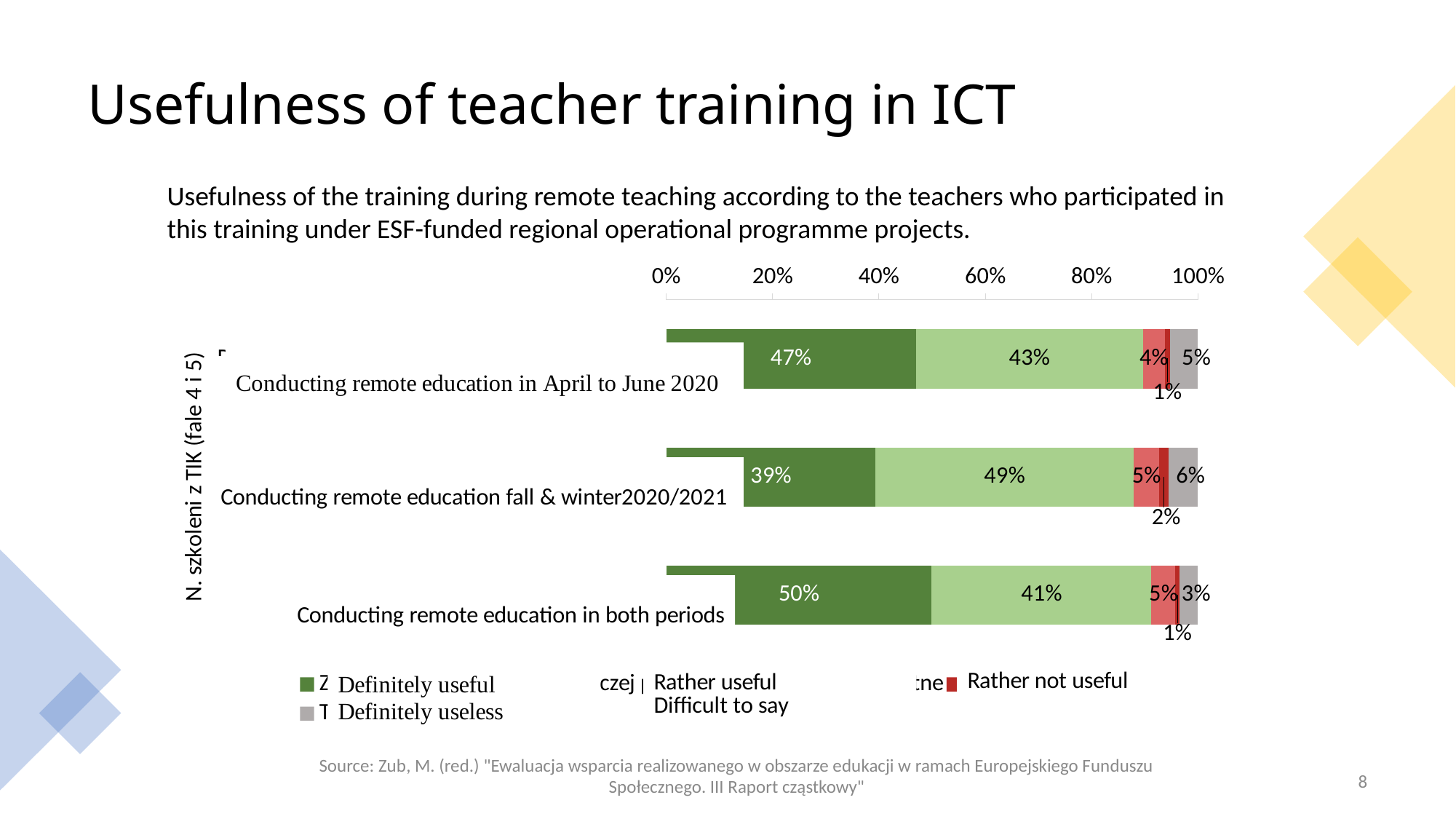
What percentage of teachers who conducted remote education in April to June 2020 found the training definitely useful? 47% How many series does the legend list? 5 Is the 'Rather useful' share larger for teachers in April to June 2020 or for teachers in fall & winter 2020/2021? Fall & winter 2020/2021 What kind of chart is shown on the slide? Stacked bar chart What is the combined share of 'Definitely useful' and 'Rather useful' for teachers conducting remote education in April to June 2020? 90% What percentage of teachers who conducted remote education in both periods found the training definitely useful? 50% Which category has the lowest share of teachers who found the training definitely useful? Conducting remote education fall & winter2020/2021 Which category has the highest share of teachers who found the training definitely useful? Conducting remote education in both periods How many categories (bars) are shown in the chart? 3 What is the difference between the 'Definitely useful' shares for teachers conducting remote education in both periods and those in fall & winter 2020/2021? 11 percentage points What percentage of teachers who conducted remote education in fall & winter 2020/2021 found the training rather useful? 49%